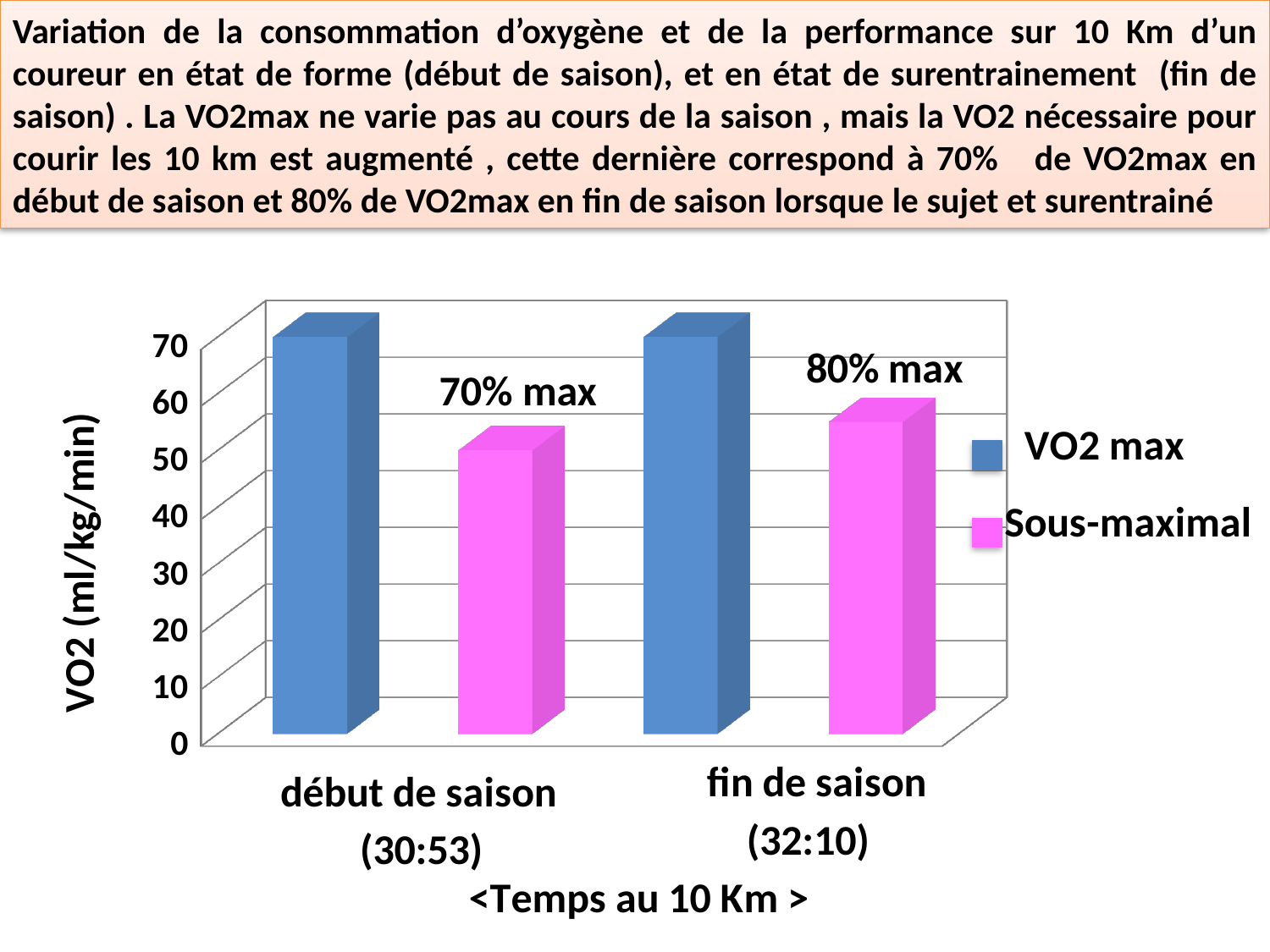
Is the Sous-maximal value for début de saison greater or less than 60? less Does the Sous-maximal value rise or fall from début de saison to fin de saison? rise What is the y-axis label of the chart? VO2 (ml/kg/min) How many series does the legend list? 2 What kind of chart is shown on the slide? bar chart Is the Sous-maximal value for fin de saison greater or less than 50? greater For début de saison, which is larger: VO2 max or Sous-maximal? VO2 max What 10 km time is shown under the fin de saison category? 32:10 How many categories are shown on the x axis? 2 Is the VO2 max value for début de saison greater or less than 60? greater Which category has the larger Sous-maximal value: début de saison or fin de saison? fin de saison What label is printed above the Sous-maximal bar for fin de saison? 80% max